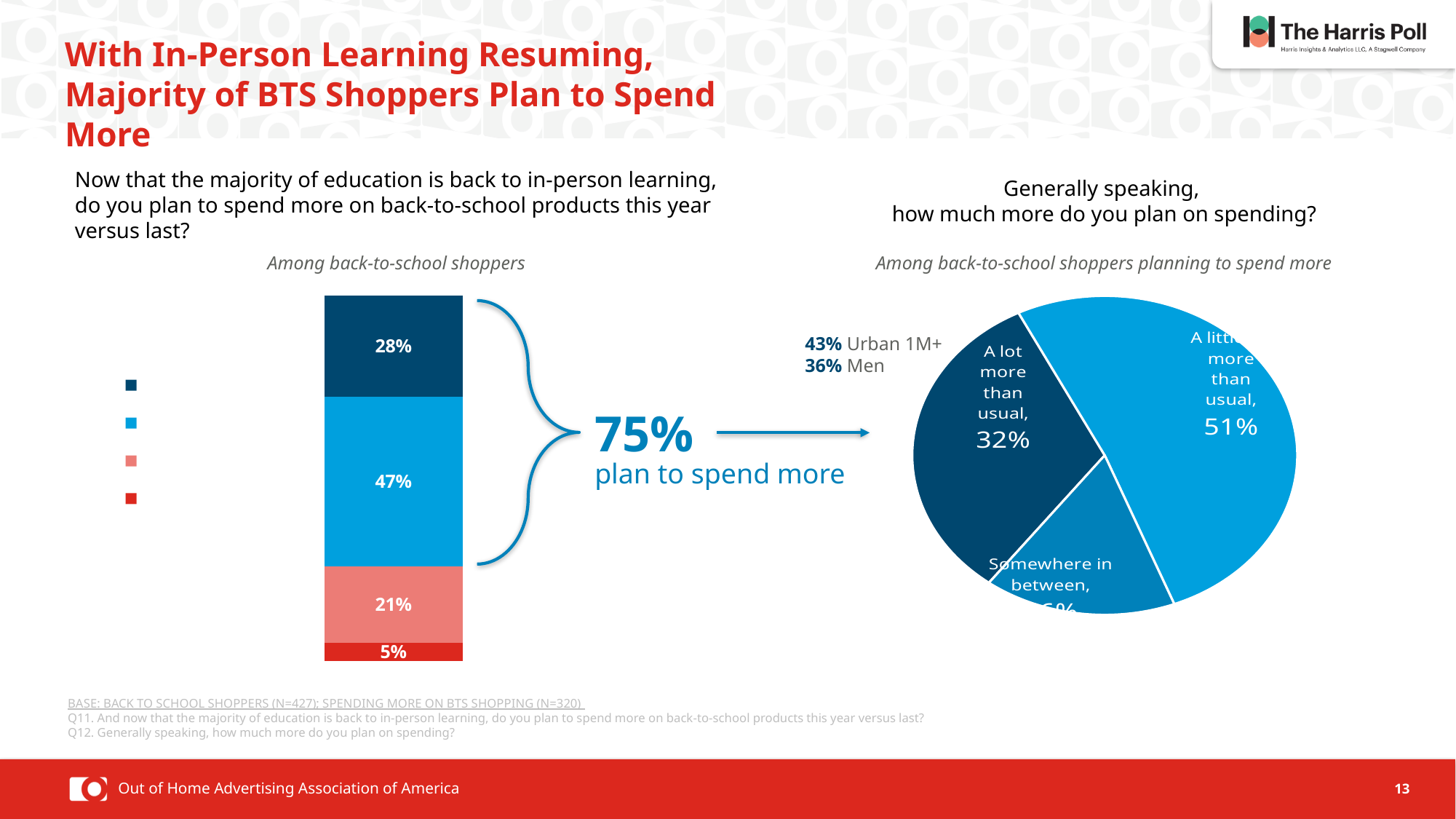
What kind of chart is the chart on the right of the slide? Pie chart In the pie chart on the right, which slice is the largest? A little more than usual In the pie chart on the right, what share is 'A lot more than usual'? 32% In the stacked bar chart on the left, what is the value of the top (dark blue) segment? 28% In the pie chart on the right, what share is 'A little more than usual'? 51% In the stacked bar chart on the left, what is the value of the largest segment? 47% In the stacked bar chart on the left, what is the value of the smallest segment? 5% In the pie chart on the right, how many slices are there? 3 What kind of chart is the chart on the left of the slide? Bar chart In the stacked bar chart on the left, what is the difference between the 47% segment and the 28% segment? 19 percentage points According to the callout between the two charts, what percentage plan to spend more? 75% In the stacked bar chart on the left, how many segments make up the bar? 4